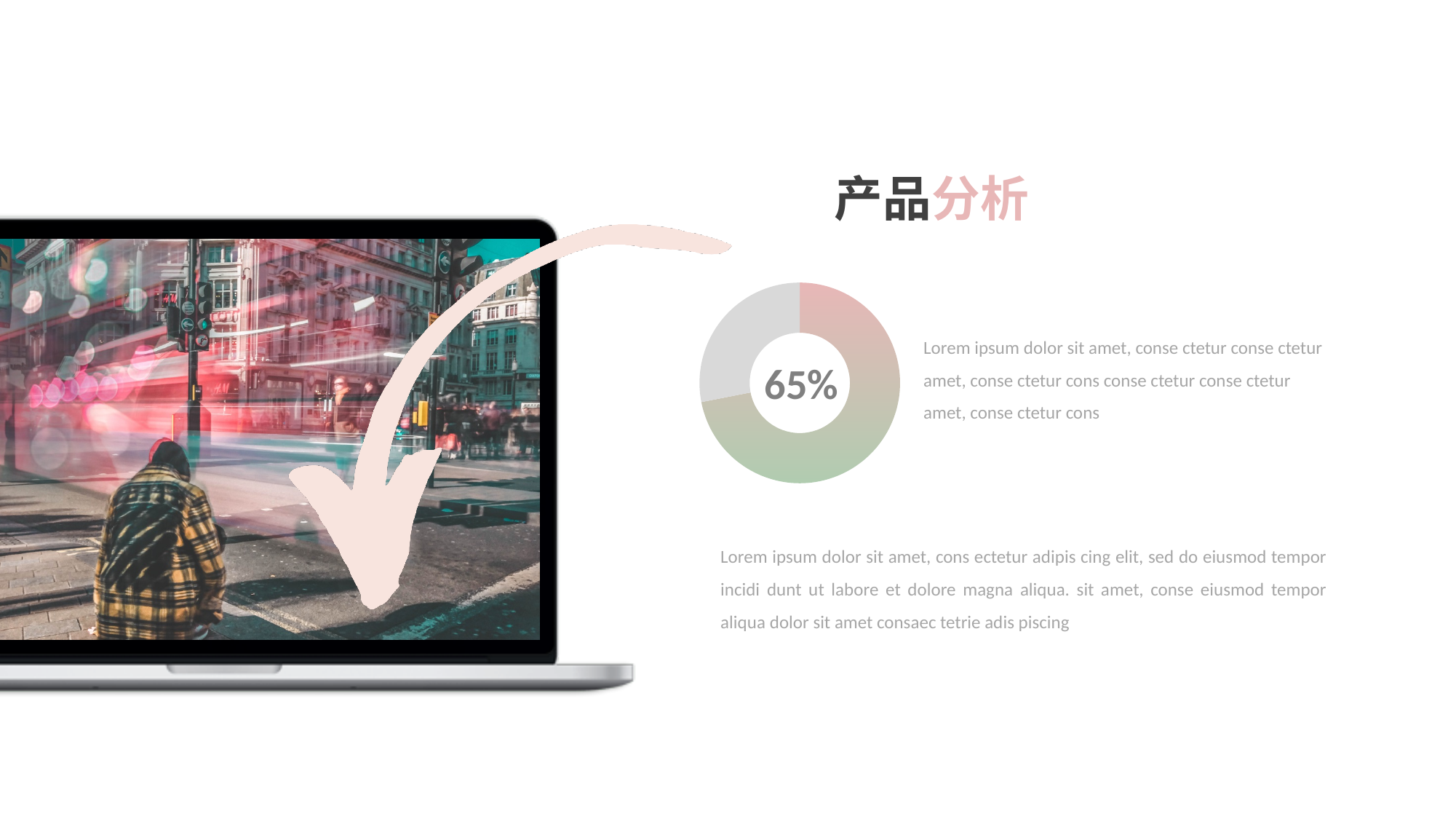
What kind of chart is shown on the slide? Donut (pie) chart What colours are the three slices of the donut chart? Pink, green and grey How many slices does the donut chart have? 3 What percentage is printed in the centre of the donut chart? 65% What is the title shown above the donut chart? 产品分析